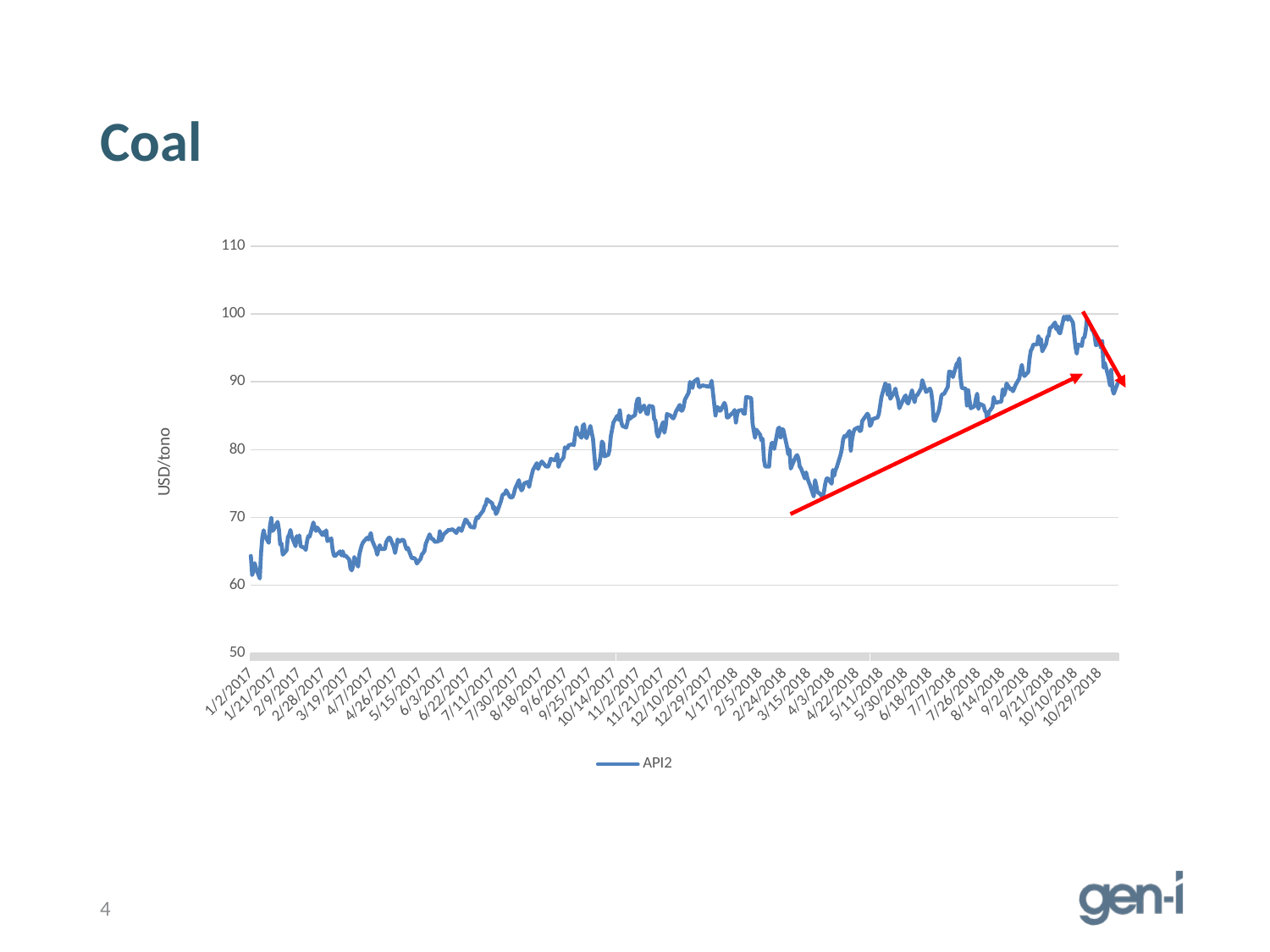
Is the API2 value around 6/3/2017 greater or less than 70? less How many series does the legend list? 1 Does the API2 line generally rise or fall from 1/2/2017 to 12/29/2017? rise In which year does the API2 line reach its highest value? 2018 What kind of chart is shown on the slide? line chart Is the API2 value around 10/10/2018 greater or less than 90? greater What is the name of the series shown in the legend? API2 Is the API2 value at 1/2/2017 greater or less than 70? less What is the label on the vertical axis? USD/tono